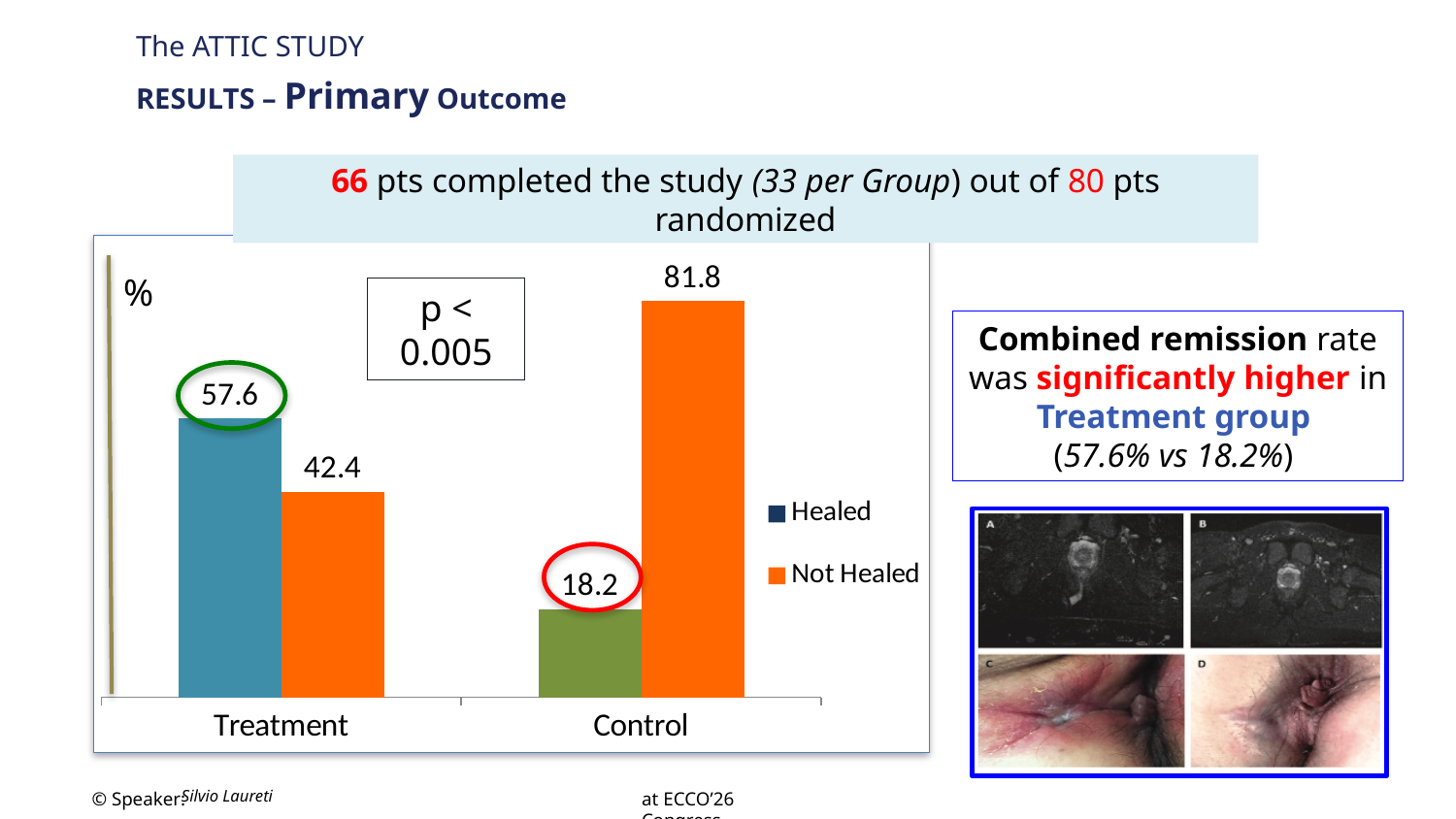
What is the Healed value for the Treatment group? 57.6 Which group has the higher Healed value? Treatment What is the difference between the Healed values of the Treatment and Control groups? 39.4 How many series does the chart legend list? 2 What is the Not Healed value for the Control group? 81.8 What is the Not Healed value for the Treatment group? 42.4 How many groups are shown on the x axis of the chart? 2 Which bar in the chart is the shortest? Healed for Control What type of chart is shown on the slide? Bar chart Which bar in the chart is the tallest? Not Healed for Control What is the difference between the Not Healed values of the Control and Treatment groups? 39.4 What is the Healed value for the Control group? 18.2